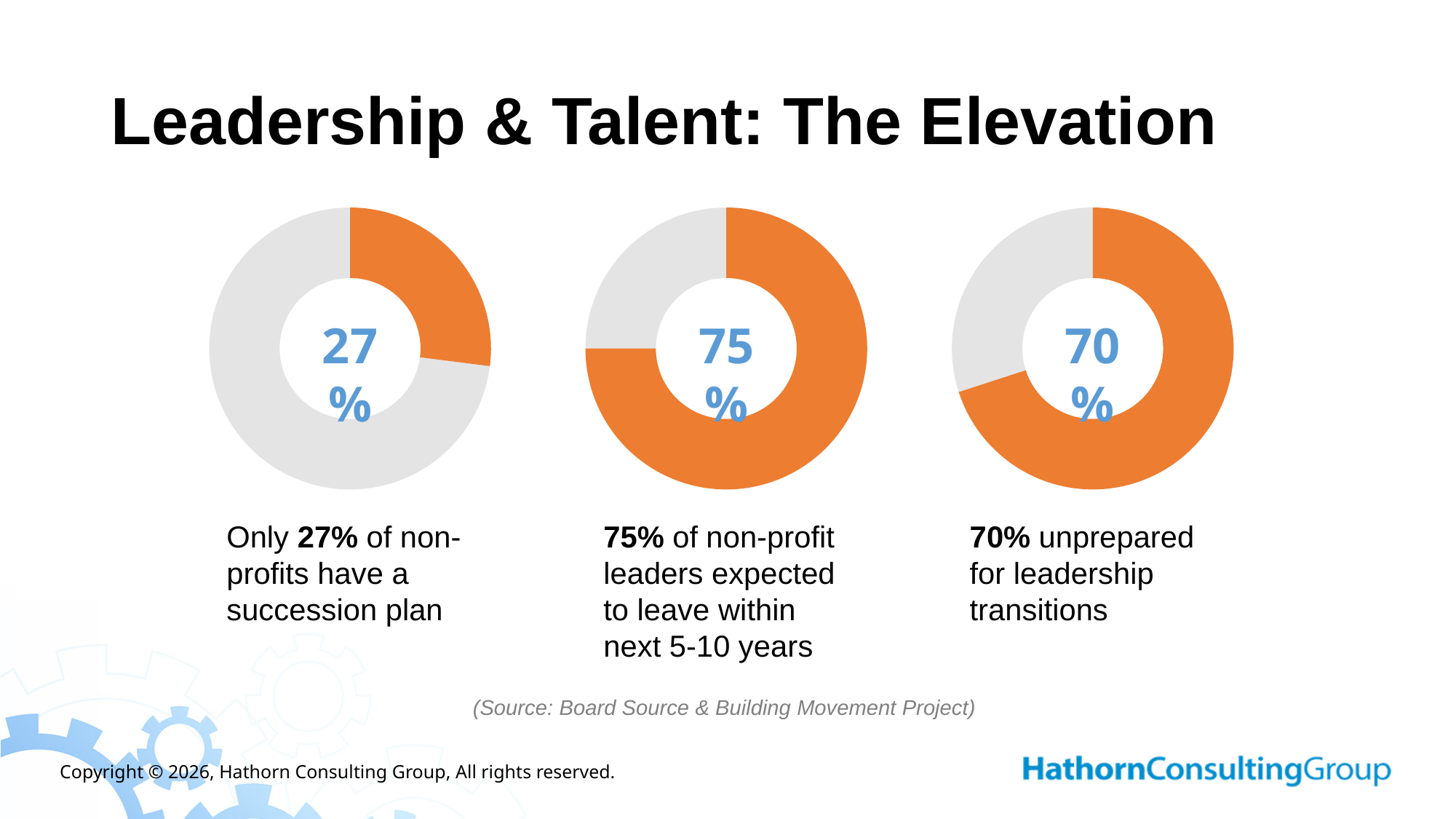
Which of the three donut charts shows the lowest percentage? The left chart (27%) What is the difference between the percentage in the middle donut chart and the percentage in the left donut chart? 48 percentage points How many donut charts are shown on the slide? 3 What kind of chart is used to display the three percentages on the slide? Donut (pie) chart In the left donut chart, what percentage is shown in the centre? 27% In the middle donut chart, what percentage is shown in the centre? 75% In the right donut chart, what percentage is shown in the centre? 70% Which of the three donut charts shows the highest percentage? The middle chart (75%) In the left donut chart, what share of the ring is the grey (non-highlighted) portion? 73% Which is larger: the percentage in the left donut chart or the percentage in the right donut chart? The right chart (70%) What colour is used for the highlighted slice in each donut chart? Orange What is the difference between the percentage in the middle donut chart and the percentage in the right donut chart? 5 percentage points